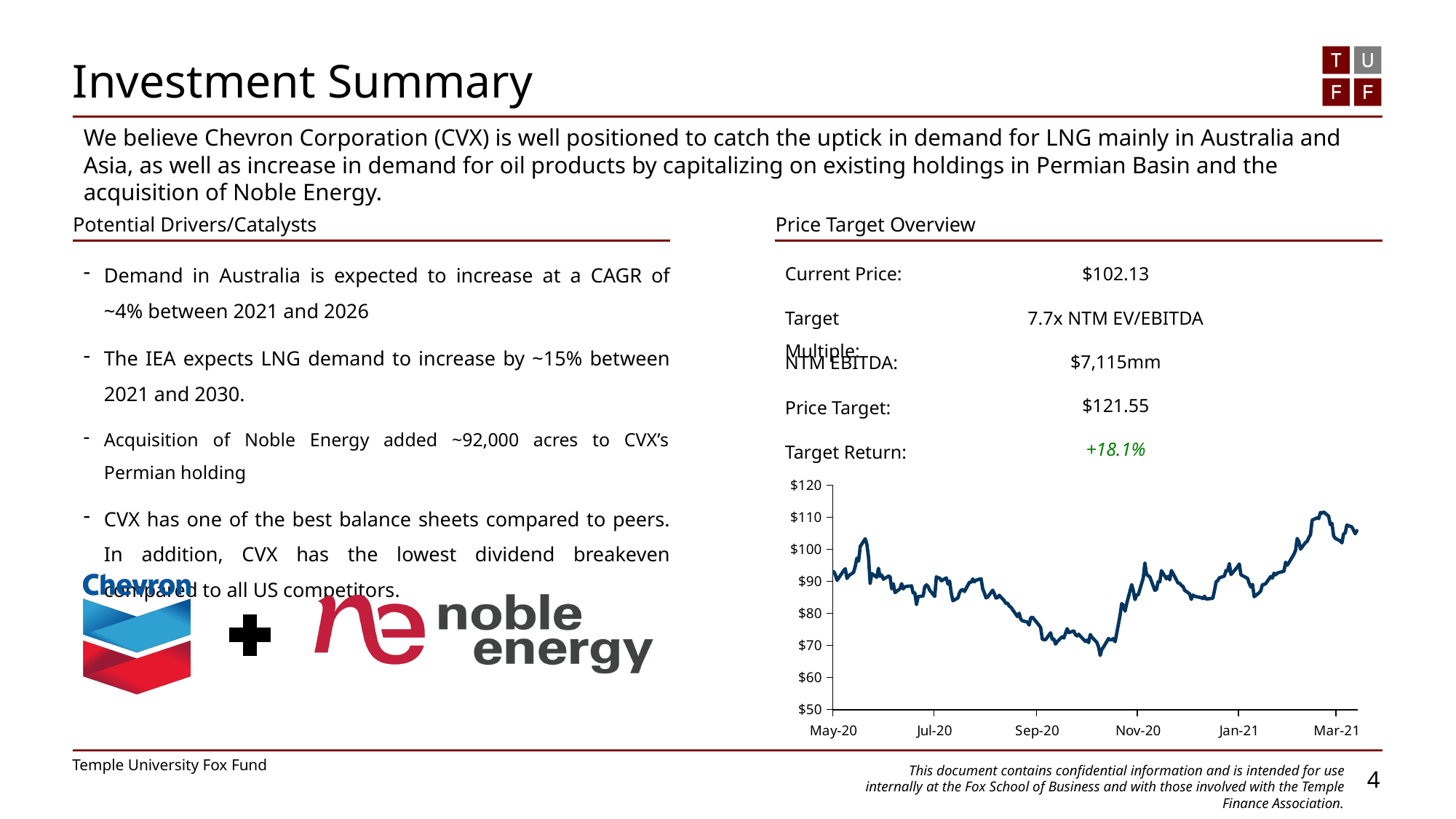
Is the value at Mar-21 higher or lower than the value at Nov-20? higher Is the value at Jan-21 greater or less than $80? greater What is the lowest value shown on the y axis of the chart? $50 Does the line generally rise or fall between Nov-20 and Mar-21? rise How many date labels are shown on the x axis of the chart? 6 Does the line generally rise or fall between May-20 and Nov-20? fall Is the value at Mar-21 greater or less than $100? greater Is the lowest point of the line greater or less than $70? less What is the highest value shown on the y axis of the chart? $120 Between which two x-axis labels does the line reach its lowest point? Sep-20 and Nov-20 What kind of chart is shown on the slide? line chart